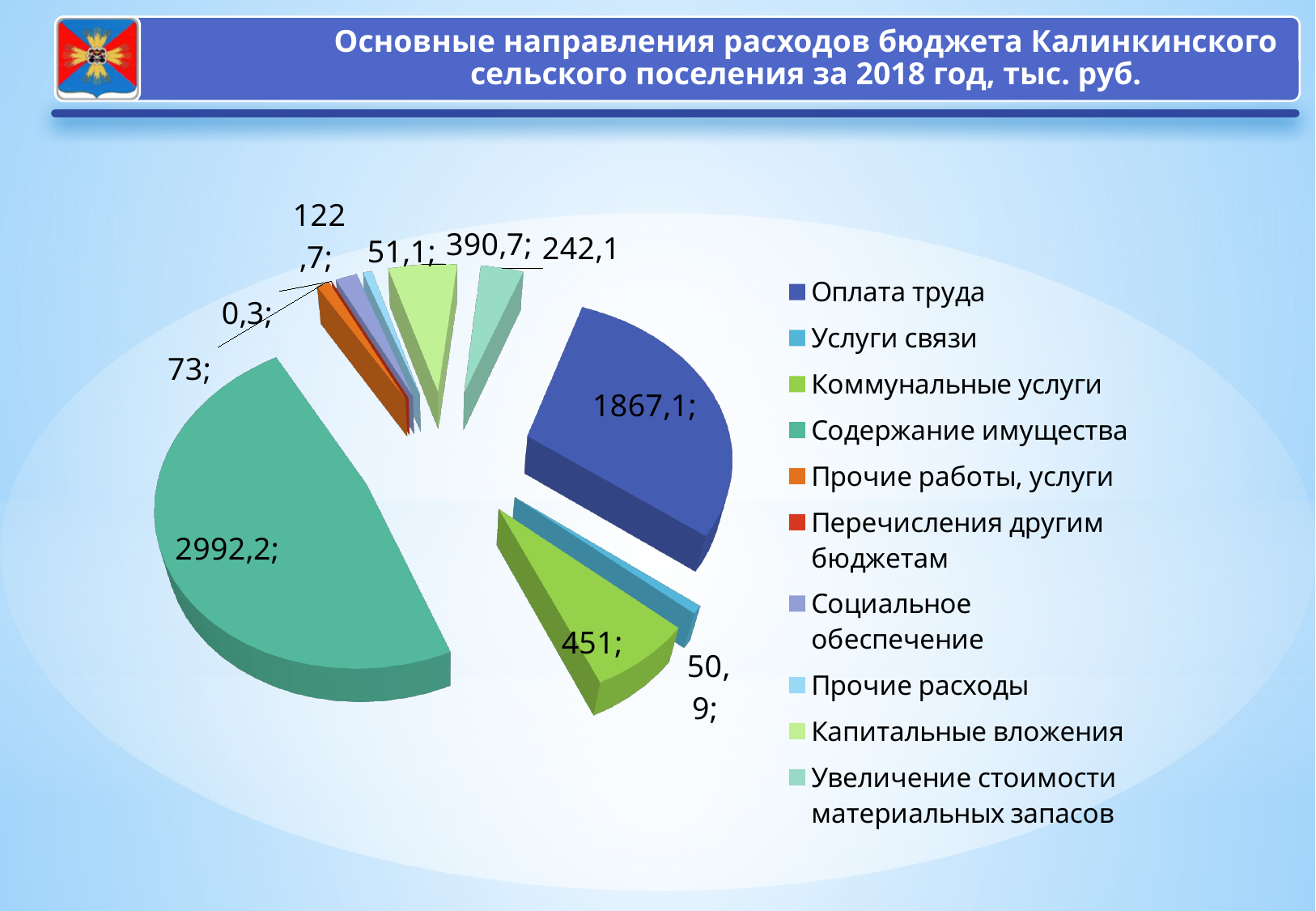
What is the title of the chart on the slide? Основные направления расходов бюджета Калинкинского сельского поселения за 2018 год, тыс. руб. What is the value for Капитальные вложения? 390,7 Which category has the smallest value in the pie chart? Перечисления другим бюджетам Which is larger, the value for Коммунальные услуги or the value for Капитальные вложения? Коммунальные услуги What is the value for Увеличение стоимости материальных запасов? 242,1 How many categories does the legend of the pie chart list? 10 Which category has the largest value in the pie chart? Содержание имущества What is the difference between the values for Содержание имущества and Оплата труда? 1125,1 What is the value for Содержание имущества? 2992,2 What is the value for Оплата труда? 1867,1 What type of chart is shown on the slide? pie chart What is the value for Коммунальные услуги? 451